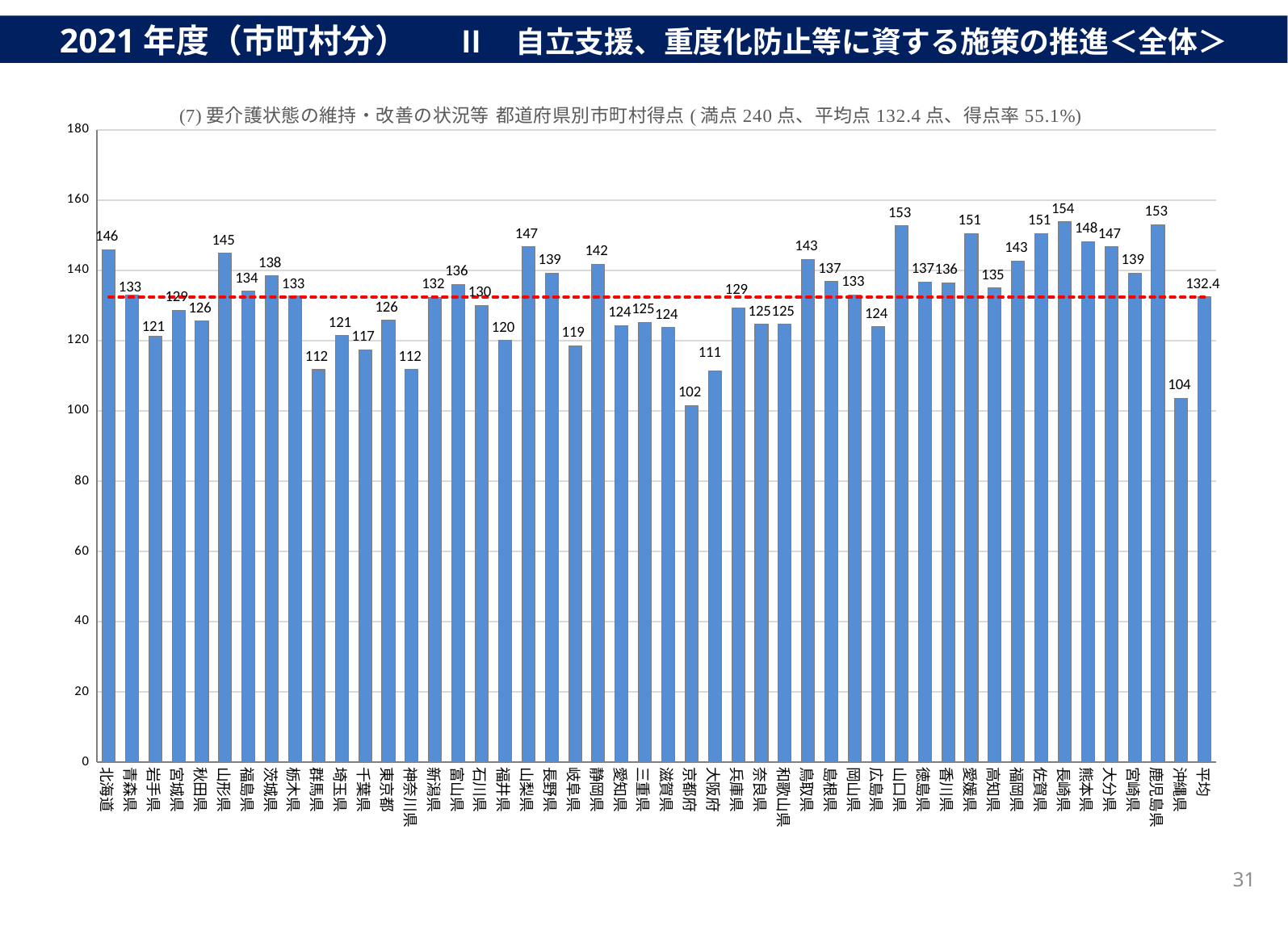
Is the value for 大阪府 greater or less than 120? less Which prefecture has the lowest value? 京都府 Which prefecture has the highest value? 長崎県 What is the value for 長崎県? 154 What kind of chart is shown on the slide? bar chart What is the value shown for 平均 (the last bar)? 132.4 What is the value for 京都府? 102 Which is larger, the value for 山口県 or the value for 沖縄県? 山口県 What is the difference between the values for 鹿児島県 and 宮崎県? 14 What is the difference between the values for 長崎県 and 京都府? 52 What is the value for 北海道? 146 What value does the red dashed horizontal line represent, according to the chart title? 平均点 132.4点